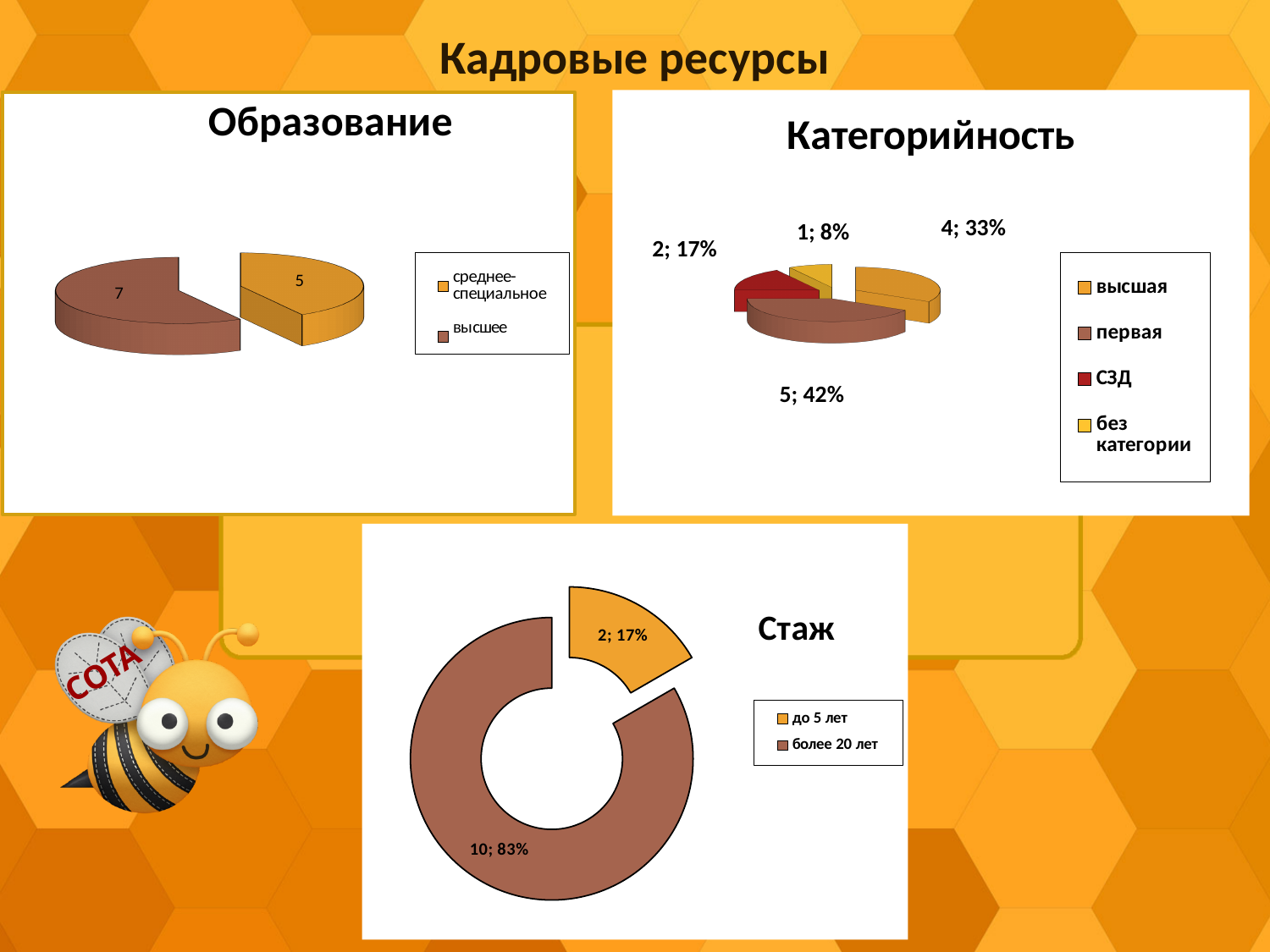
In the 'Образование' chart, what is the difference between 'высшее' and 'среднее-специальное'? 2 In the 'Категорийность' chart, what is the value for 'высшая'? 4 In the 'Категорийность' chart, what share does 'первая' have? 42% In the 'Стаж' chart, what is the value for 'до 5 лет'? 2 In the 'Категорийность' chart, which category has the smallest value? без категории In the 'Образование' chart, which category has the larger value? высшее In the 'Категорийность' chart, what is the total of all slice values? 12 What kind of chart is the 'Стаж' chart? doughnut chart In the 'Образование' chart, what is the value for 'среднее-специальное'? 5 In the 'Категорийность' chart, how many categories are shown in the legend? 4 In the 'Образование' chart, what is the value for 'высшее'? 7 In the 'Стаж' chart, what share does 'более 20 лет' have? 83%